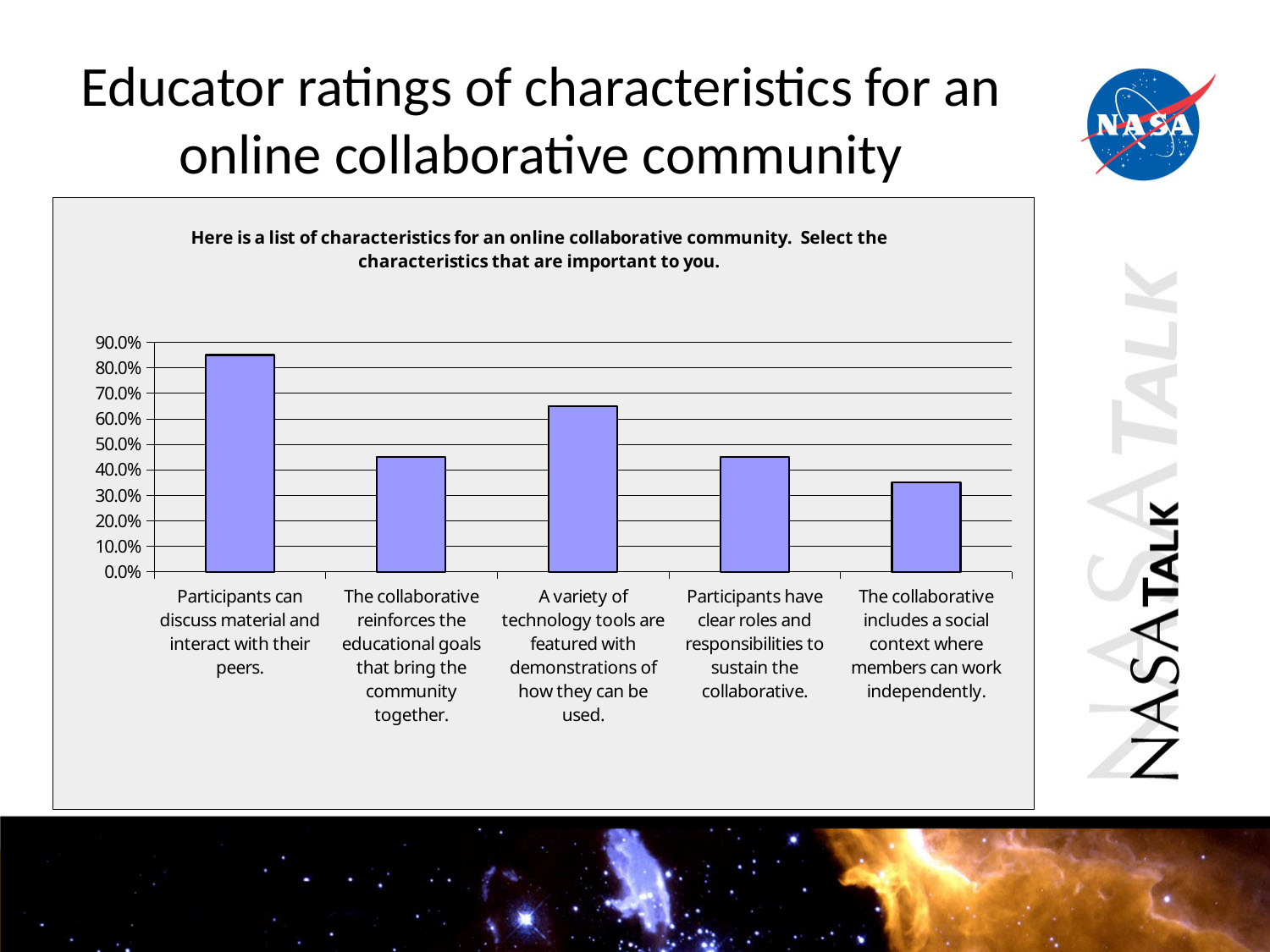
Is the value for "Participants can discuss material and interact with their peers." greater or less than 80.0%? greater Is the value for "The collaborative reinforces the educational goals that bring the community together." greater or less than 50.0%? less Which is rated higher: "Participants can discuss material and interact with their peers." or "A variety of technology tools are featured with demonstrations of how they can be used."? Participants can discuss material and interact with their peers. Is the value for "A variety of technology tools are featured with demonstrations of how they can be used." greater or less than 60.0%? greater What kind of chart is shown on the slide? bar chart How many characteristics (categories) are plotted in the chart? 5 Which is rated higher: "A variety of technology tools are featured with demonstrations of how they can be used." or "The collaborative includes a social context where members can work independently."? A variety of technology tools are featured with demonstrations of how they can be used. What is the highest value shown on the chart's vertical axis? 90.0% Which characteristic received the highest rating? Participants can discuss material and interact with their peers. Which characteristic received the lowest rating? The collaborative includes a social context where members can work independently.